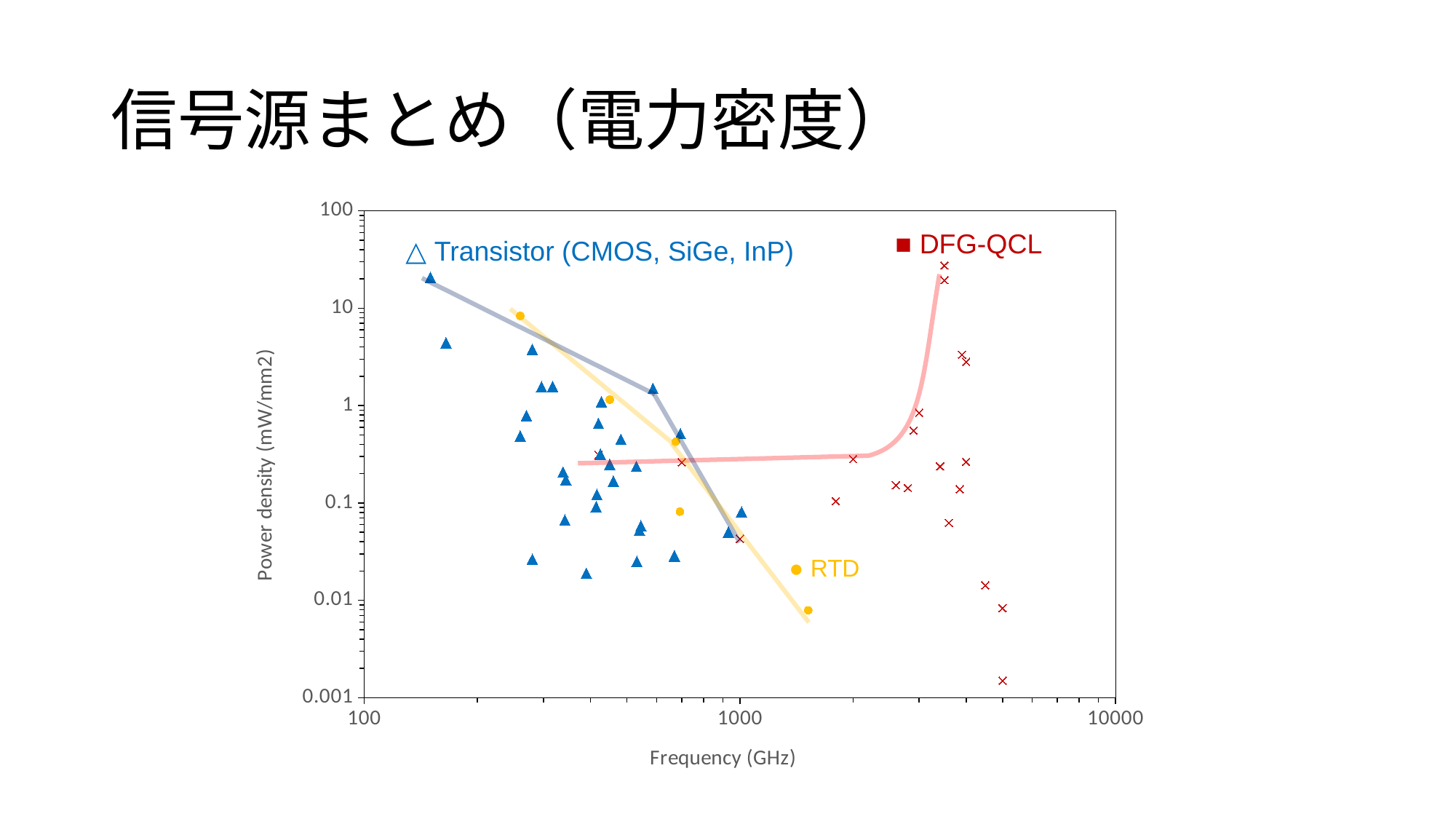
Does the trend line for the RTD series rise or fall as frequency increases? fall Is the highest power density value of the Transistor (CMOS, SiGe, InP) series greater or less than 10? greater What is the label of the vertical axis? Power density (mW/mm2) Is the lowest power density value of the DFG-QCL series greater or less than 0.01? less Is the highest power density value of the DFG-QCL series greater or less than 10? greater Does the trend line for the Transistor (CMOS, SiGe, InP) series rise or fall as frequency increases? fall Which series contains the point with the lowest power density on the chart? DFG-QCL Which series reaches the highest frequencies on the chart? DFG-QCL What kind of chart is shown on the slide? scatter chart How many series are identified in the chart's legend? 3 What is the label of the horizontal axis? Frequency (GHz)